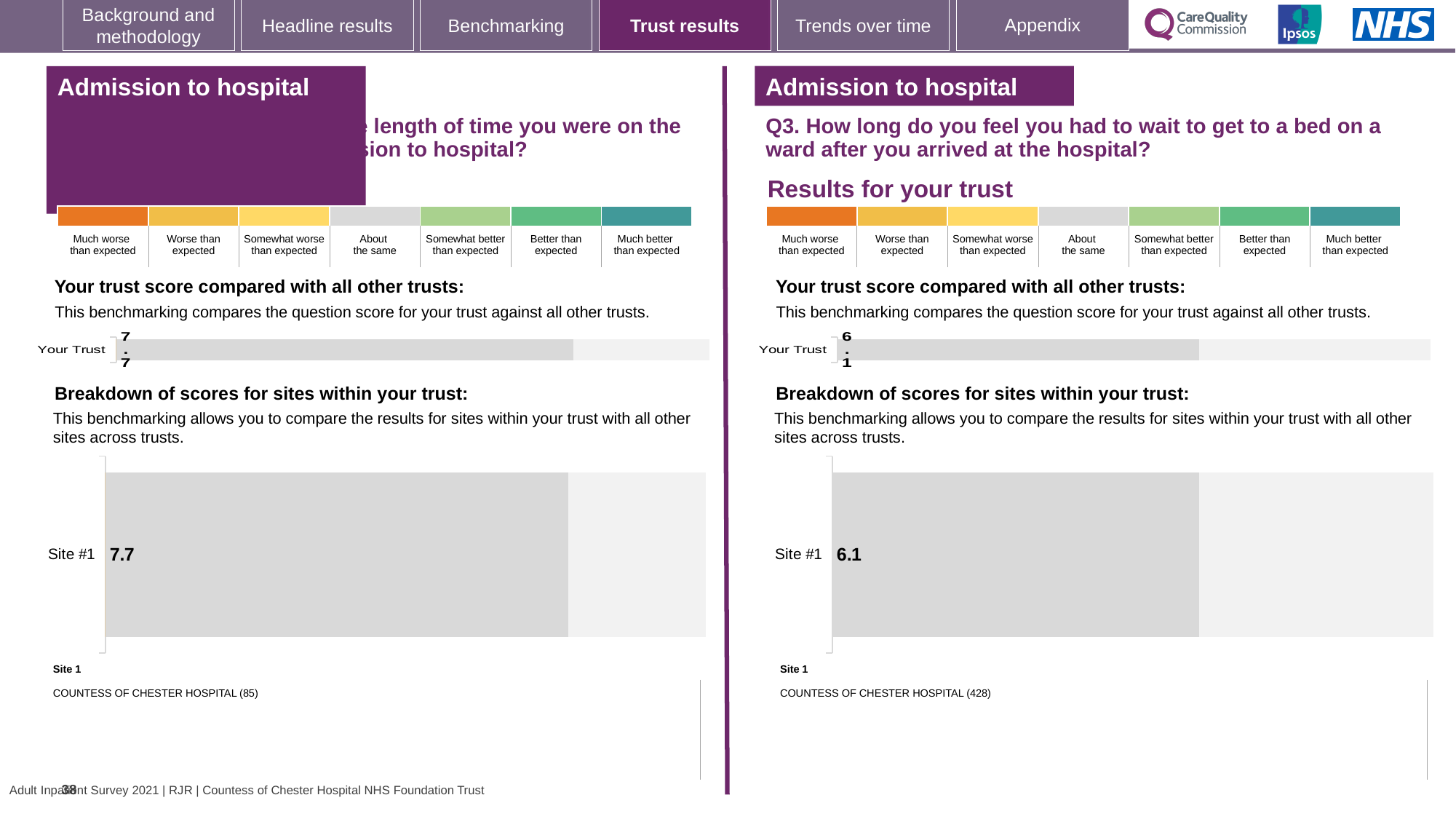
On the right half of the slide, what is the value shown for Your Trust in the 'Your trust score compared with all other trusts' bar chart? 6.1 On the left half of the slide, what is the value shown for Your Trust in the 'Your trust score compared with all other trusts' bar chart? 7.7 In the right 'Breakdown of scores for sites within your trust' chart, what is the value for Site #1? 6.1 Which site name is listed under Site 1 in the right breakdown chart? COUNTESS OF CHESTER HOSPITAL (428) What kind of chart is used for the Site #1 breakdown on the right half of the slide? Bar chart What is the difference between the Your Trust value on the left half of the slide and the Your Trust value on the right half? 1.6 Which is larger: the Site #1 value in the left breakdown chart or the Site #1 value in the right breakdown chart? Left (7.7) In the left 'Breakdown of scores for sites within your trust' chart, what is the value for Site #1? 7.7 Which survey question does the right half of the slide report results for? Q3. How long do you feel you had to wait to get to a bed on a ward after you arrived at the hospital? How many sites are plotted in the left 'Breakdown of scores for sites within your trust' chart? 1 How many sites are plotted in the right 'Breakdown of scores for sites within your trust' chart? 1 What is the difference between the Site #1 value in the left breakdown chart and the Site #1 value in the right breakdown chart? 1.6